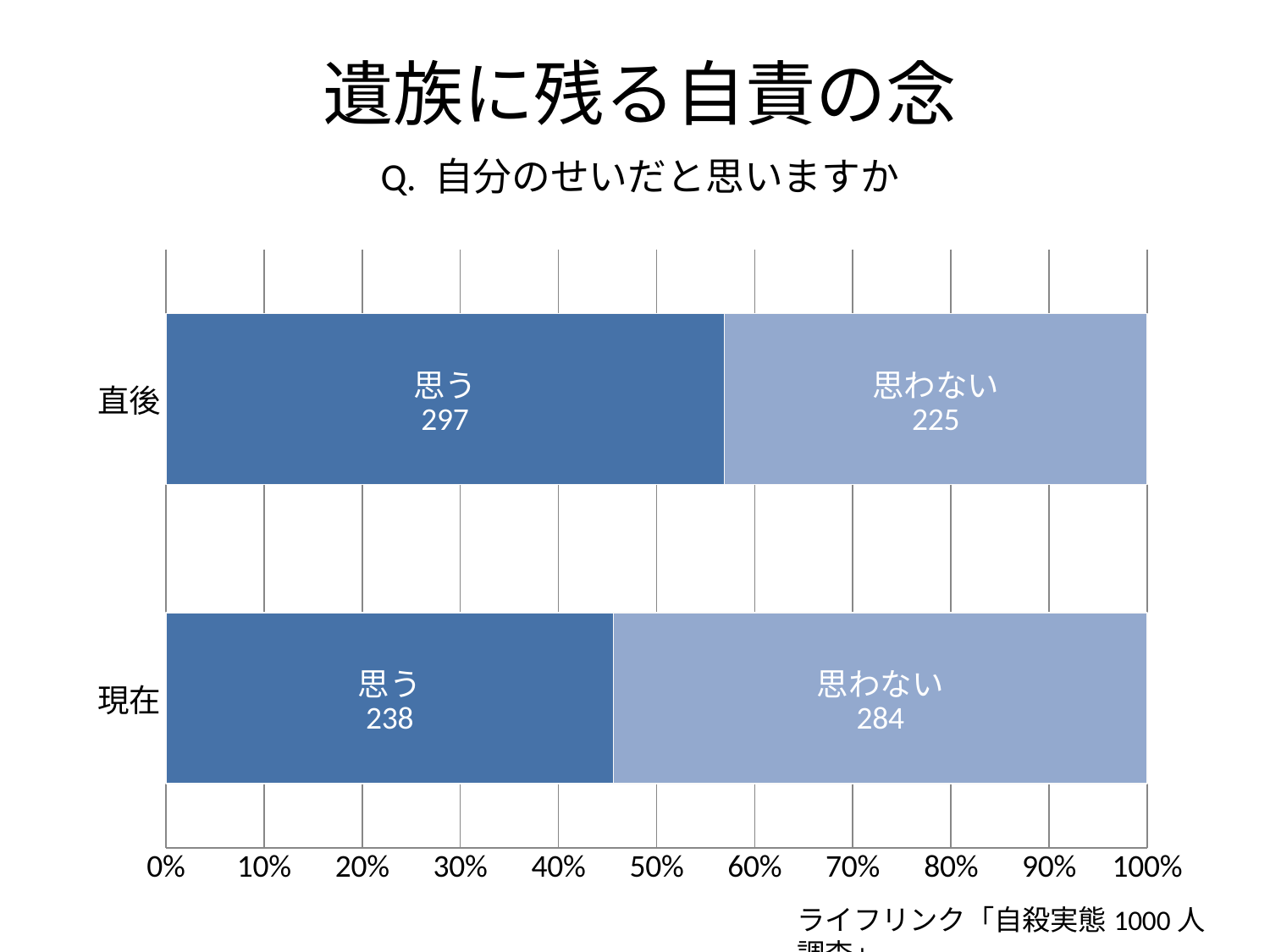
What is the difference between 思う and 思わない in the 直後 bar? 72 Which is larger in the 直後 bar, 思う or 思わない? 思う Which is larger in the 現在 bar, 思う or 思わない? 思わない What is the value for 思わない in the 直後 bar? 225 Is the share of 思う in the 現在 bar greater or less than 50%? less What is the total of the 現在 bar? 522 How many categories are plotted on the chart? 2 What is the value for 思う in the 現在 bar? 238 What is the value for 思う in the 直後 bar? 297 What is the difference between 思う for 直後 and 思う for 現在? 59 What is the value for 思わない in the 現在 bar? 284 What kind of chart is shown on the slide? bar chart